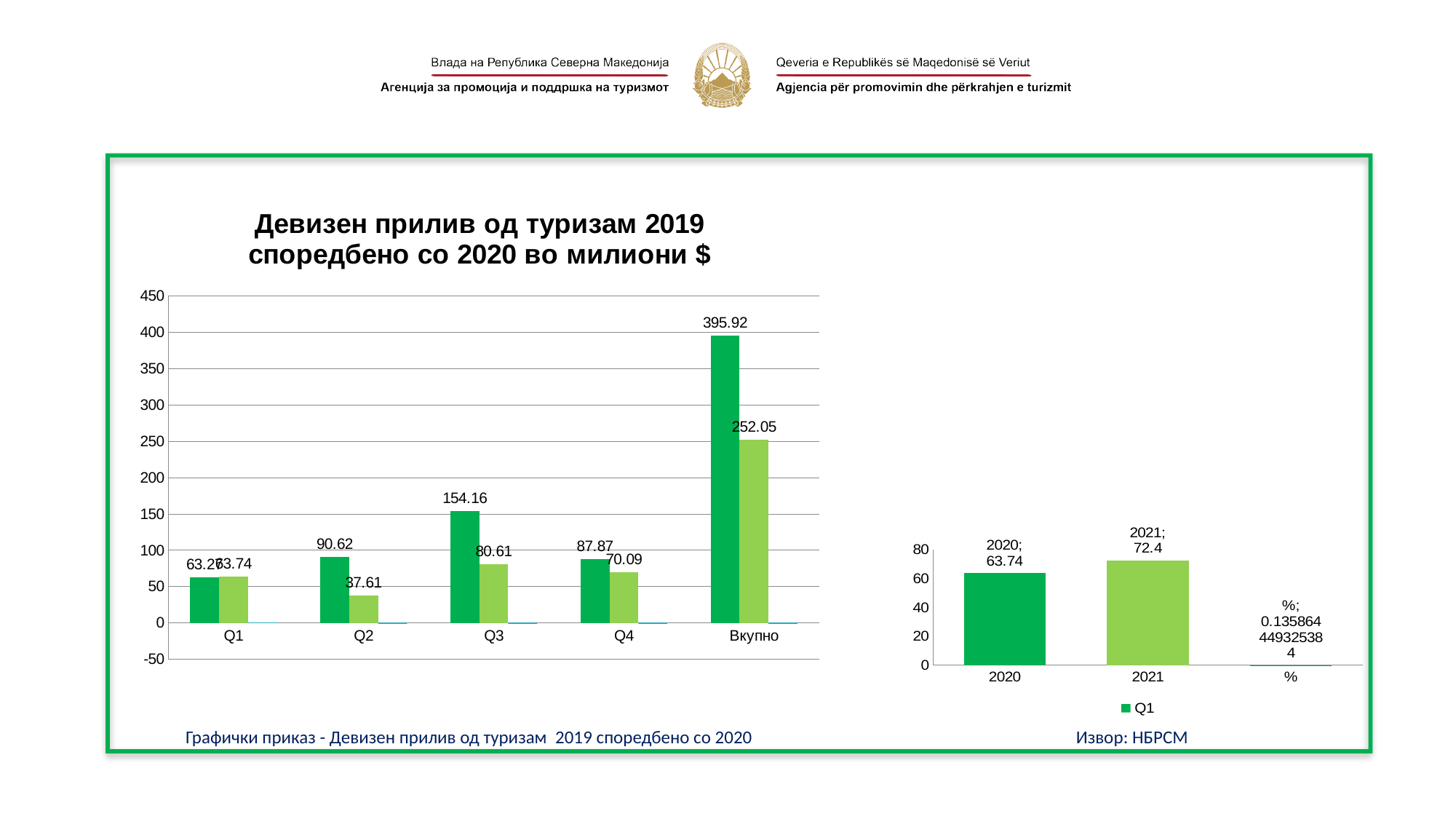
On the left chart, which quarter (Q1–Q4) has the lowest light green bar? Q2 On the left chart, what is the value of the light green bar for Q2? 37.61 On the right chart, what is the value for 2021? 72.4 What type of chart is the left chart? bar chart How many categories are shown on the x axis of the left chart? 5 On the right chart, what is the difference between the 2021 and 2020 values? 8.66 On the left chart, which category has the highest dark green bar? Вкупно On the left chart, what is the value of the light green bar for Q3? 80.61 On the left chart, what is the value of the dark green bar for Вкупно? 395.92 On the left chart, what is the difference between the dark green and light green bars for Q3? 73.55 What entry does the legend of the right chart list? Q1 On the left chart, for Q2, which bar is larger: the dark green or the light green? dark green